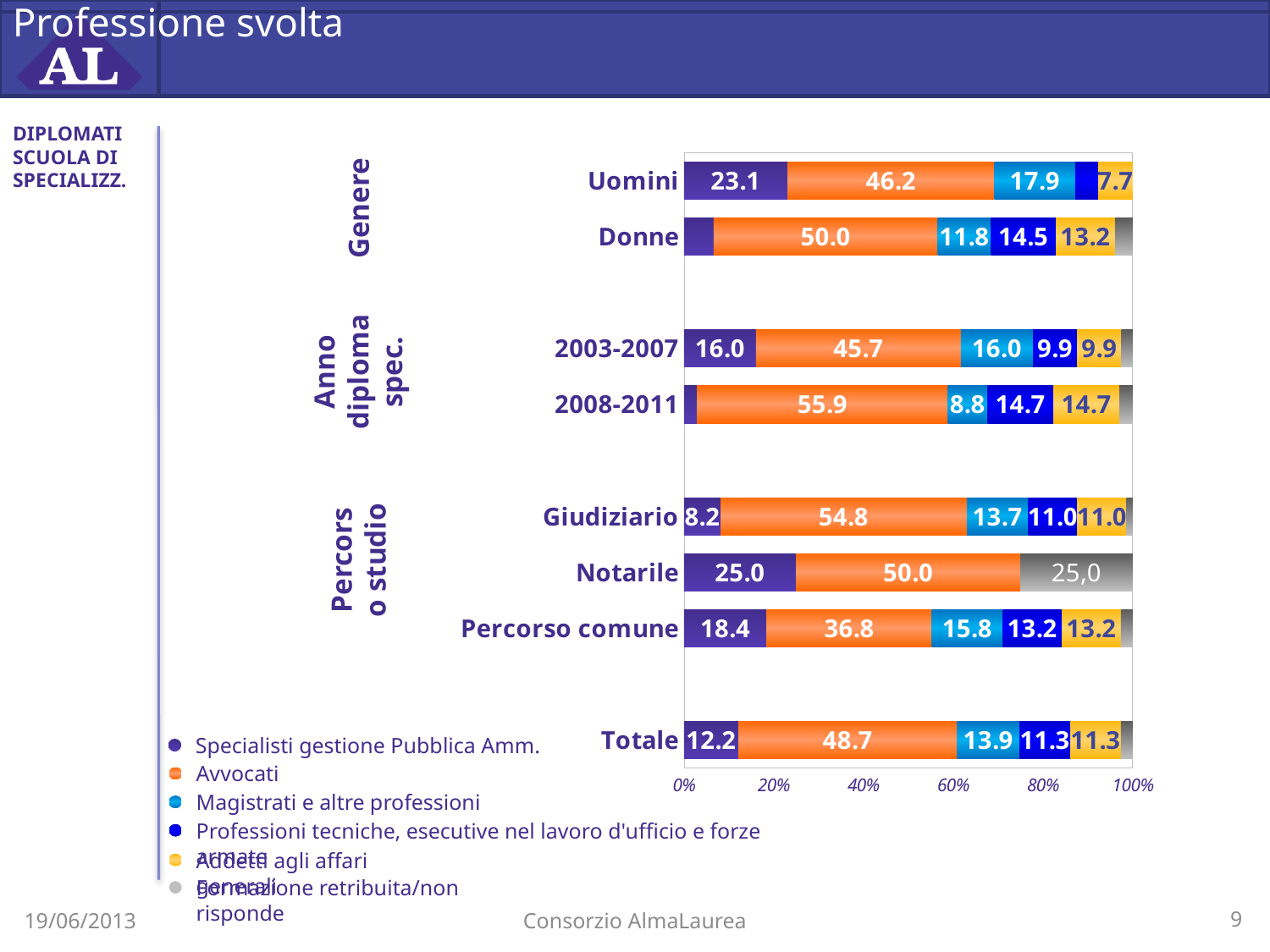
Which category has the lowest value for Avvocati? Percorso comune Which is larger, the Specialisti gestione Pubblica Amm. value for Uomini or for Percorso comune? Uomini What is the value for Avvocati in the Uomini bar? 46.2 What is the value for Magistrati e altre professioni in the Totale bar? 13.9 Which series is shown in orange in the chart? Avvocati How many series does the legend list? 6 How many categories (bars) are shown in the chart? 8 Which category has the highest value for Avvocati? 2008-2011 What is the value for Avvocati in the 2008-2011 bar? 55.9 What kind of chart is shown on the slide? Stacked bar chart What is the difference between the Avvocati values for Donne and Uomini? 3.8 What is the value for Specialisti gestione Pubblica Amm. in the Notarile bar? 25.0